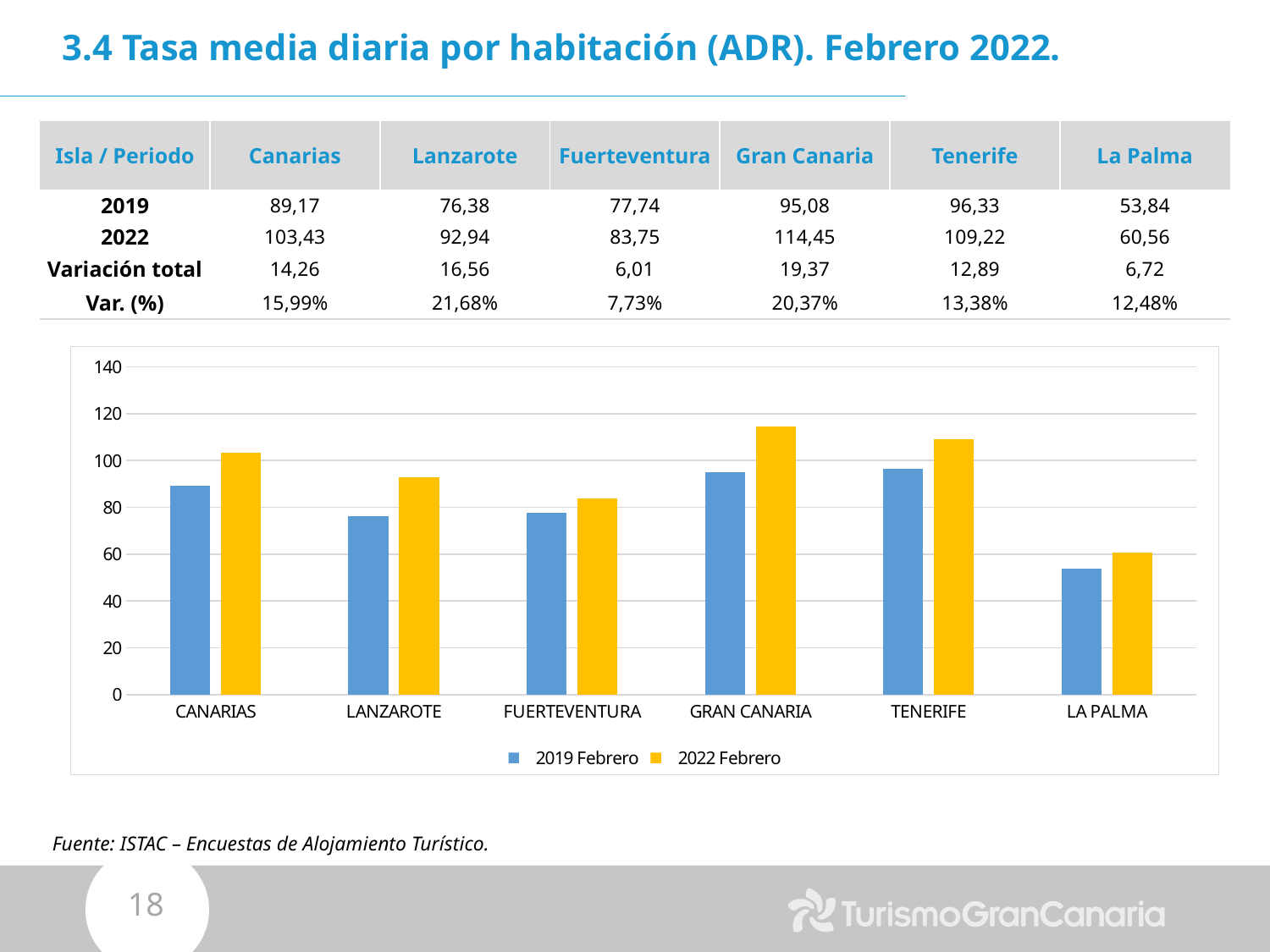
Is the 2022 Febrero value for GRAN CANARIA greater or less than 100? greater What colour are the 2022 Febrero bars in the chart? yellow According to the table on the slide, what is the difference between the 2022 and 2019 ADR values for Lanzarote? 16,56 What kind of chart is shown on the slide? bar chart Is the 2022 Febrero value for FUERTEVENTURA greater or less than 100? less According to the table on the slide, what is the 2022 ADR value for Gran Canaria? 114,45 Which category has the highest 2022 Febrero bar? GRAN CANARIA How many series does the chart legend list? 2 Which category has the lowest 2019 Febrero bar? LA PALMA Is the 2019 Febrero value for LA PALMA greater or less than 60? less How many island categories are shown on the x axis of the chart? 6 Which is larger for TENERIFE, the 2019 Febrero bar or the 2022 Febrero bar? 2022 Febrero